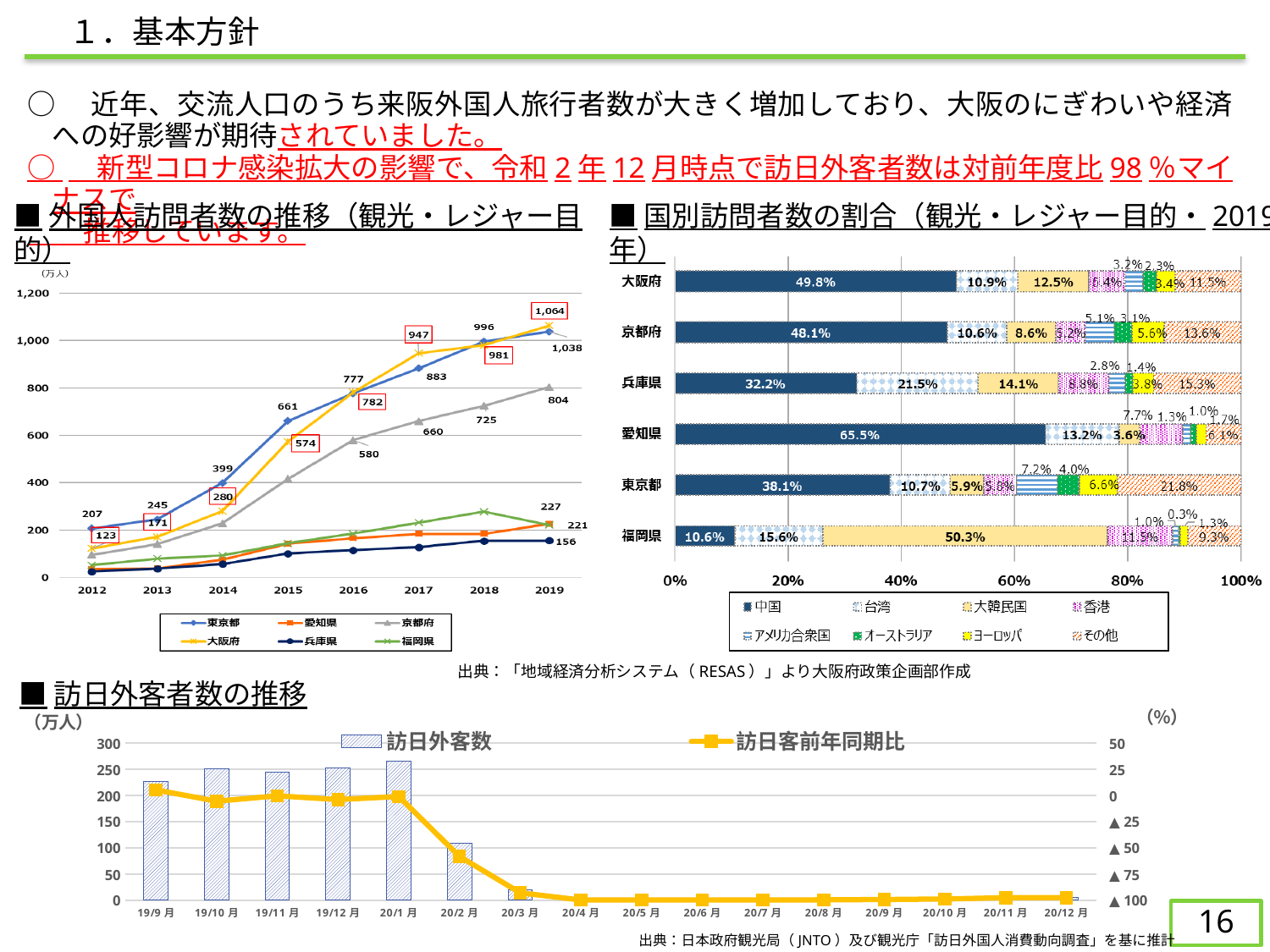
In the chart titled 外国人訪問者数の推移, does the value for 大阪府 rise or fall from 2012 to 2019? rise In the chart titled 国別訪問者数の割合, which prefecture has the highest share of 中国? 愛知県 In the chart titled 国別訪問者数の割合, which is larger, the 台湾 share for 兵庫県 or for 京都府? 兵庫県 In the chart titled 外国人訪問者数の推移, what is the value for 大阪府 in 2019? 1,064 In the chart titled 国別訪問者数の割合, how many prefectures are shown? 6 In the chart titled 国別訪問者数の割合, what is the share of 大韓民国 for 福岡県? 50.3% In the chart titled 外国人訪問者数の推移, what is the value for 東京都 in 2012? 207 In the chart titled 国別訪問者数の割合, what is the share of 中国 for 愛知県? 65.5% In the chart titled 外国人訪問者数の推移, what is the difference between 東京都 and 大阪府 in 2017? 64 In the chart titled 外国人訪問者数の推移, how many series does the legend list? 6 What kind of chart is the chart titled 訪日外客者数の推移 at the bottom of the slide? Combined bar and line chart In the chart titled 訪日外客者数の推移, is the 訪日外客数 bar for 20/1月 greater or less than 250? greater